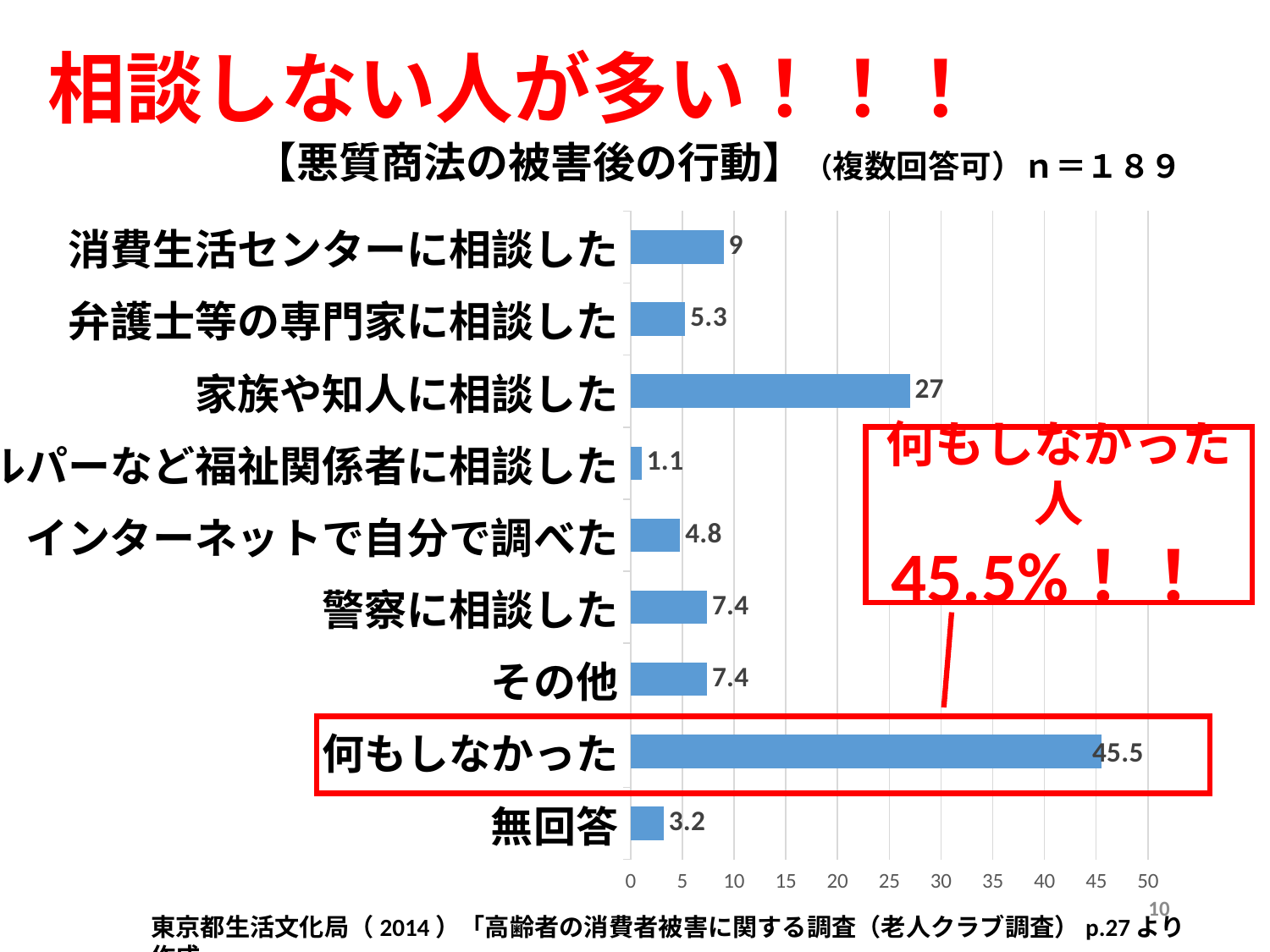
Which is larger, 弁護士等の専門家に相談した or 警察に相談した? 警察に相談した Is the value for 家族や知人に相談した greater or less than 25? greater What is the value for 家族や知人に相談した? 27 What is the value for 消費生活センターに相談した? 9 What is the sample size (n) stated in the chart title? 189 What kind of chart is shown on the slide? bar chart What is the value for 何もしなかった? 45.5 What is the difference between 何もしなかった and 家族や知人に相談した? 18.5 What is the value for インターネットで自分で調べた? 4.8 What is the value for 無回答? 3.2 How many categories are shown in the chart? 9 Which category has the highest value? 何もしなかった